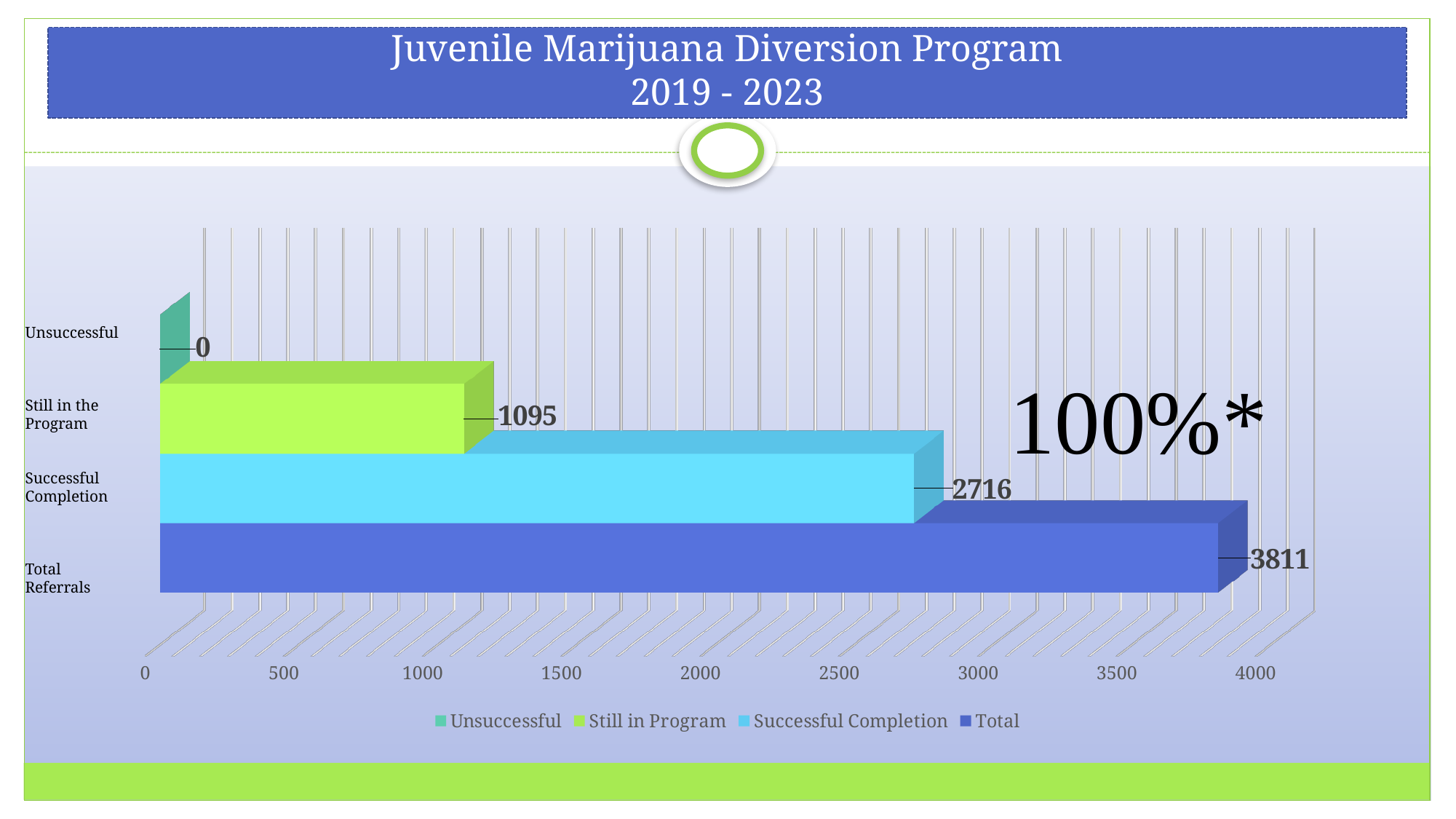
What is the difference between Total Referrals and Successful Completion? 1095 What is the value for Total Referrals? 3811 How many categories are shown in the chart? 4 How many entries does the legend list? 4 Which category has the highest value? Total Referrals What is the value for Still in the Program? 1095 Which is larger, Successful Completion or Still in the Program? Successful Completion What is the difference between Successful Completion and Still in the Program? 1621 What is the value for Successful Completion? 2716 What kind of chart is shown on the slide? Bar chart What is the value for Unsuccessful? 0 Which category has the lowest value? Unsuccessful